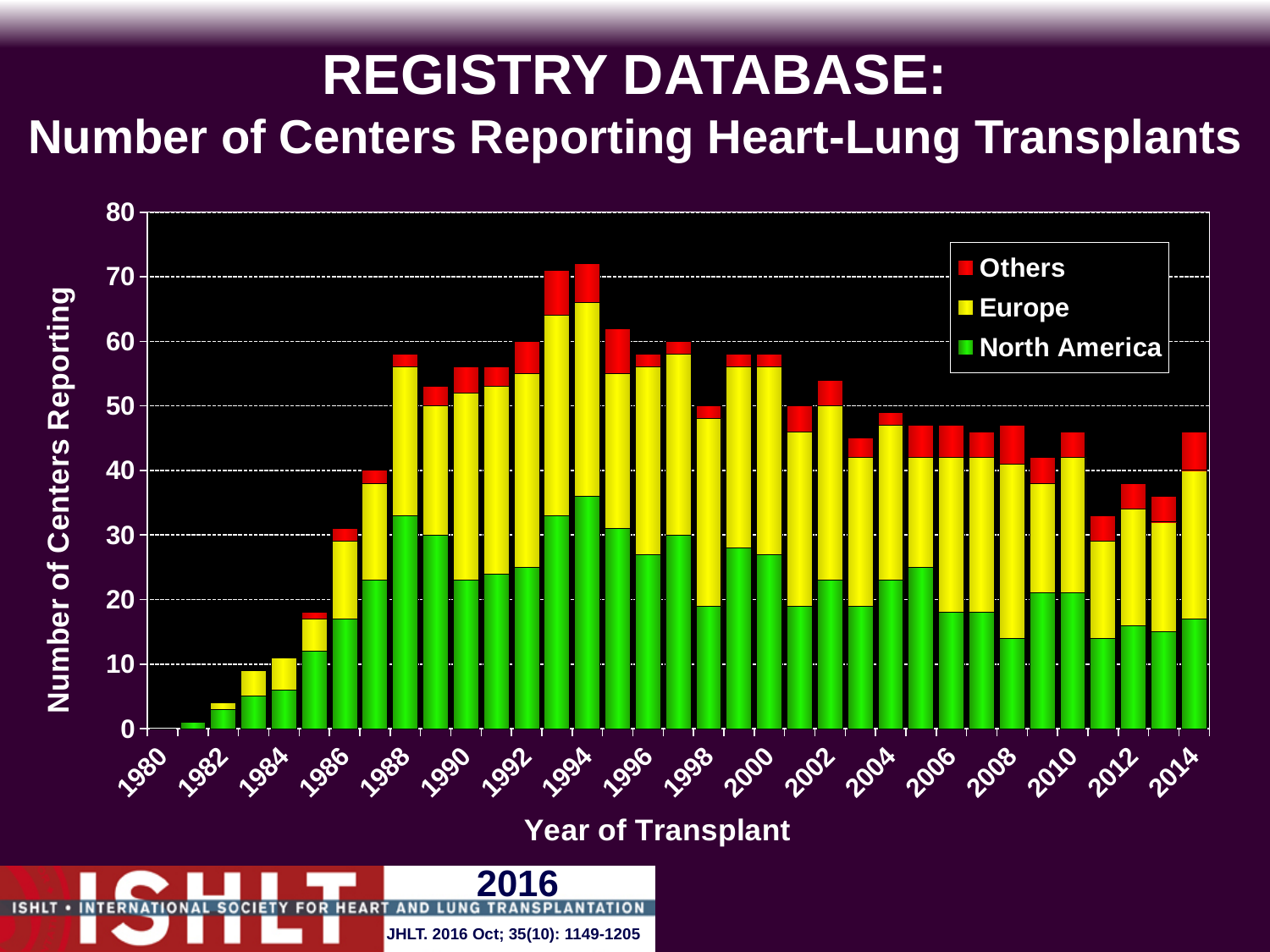
Do the total numbers of centers reporting generally rise or fall from 1994 to 2011? Fall Is the total number of centers reporting in 2014 greater or less than 40? greater Which year has a larger total number of centers reporting, 1988 or 2012? 1988 Is the total number of centers reporting in 2011 greater or less than 40? less What kind of chart is shown on the slide? Stacked bar chart What colour represents North America in the chart? Green Is the total number of centers reporting in 1994 greater or less than 60? greater How many series does the legend list? 3 Which series are listed in the legend? Others, Europe, North America